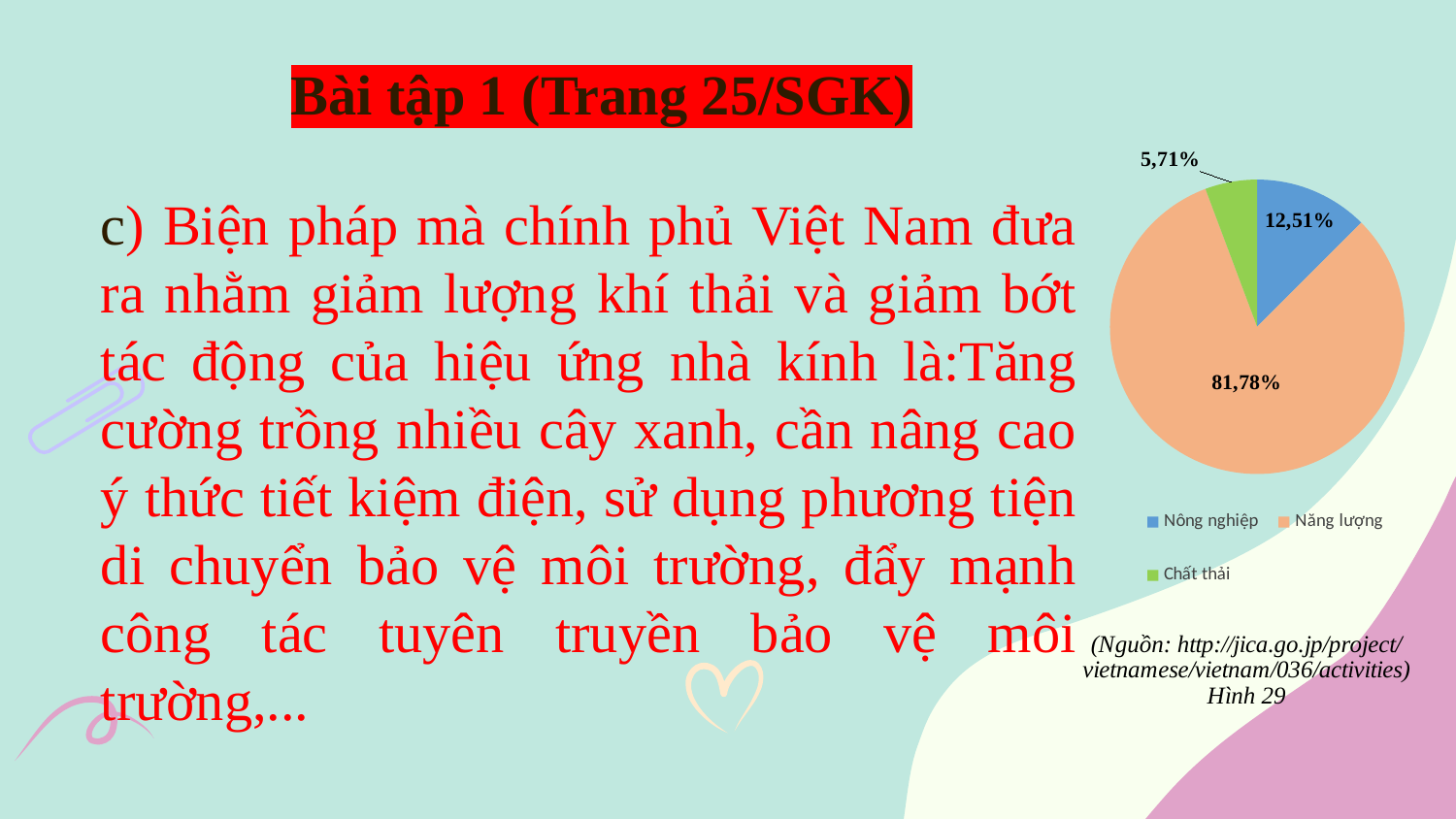
Which is larger in the pie chart, Nông nghiệp or Chất thải? Nông nghiệp What colour is the Chất thải slice in the pie chart? green What is the value for Năng lượng in the pie chart? 81,78% How many slices does the pie chart have? 3 What is the value for Chất thải in the pie chart? 5,71% Which category has the largest slice in the pie chart? Năng lượng How many entries does the legend of the pie chart list? 3 What is the value for Nông nghiệp in the pie chart? 12,51% What colour is the Nông nghiệp slice in the pie chart? blue Which category has the smallest slice in the pie chart? Chất thải What share of the pie does Năng lượng represent? 81,78% What kind of chart is shown on the slide? pie chart